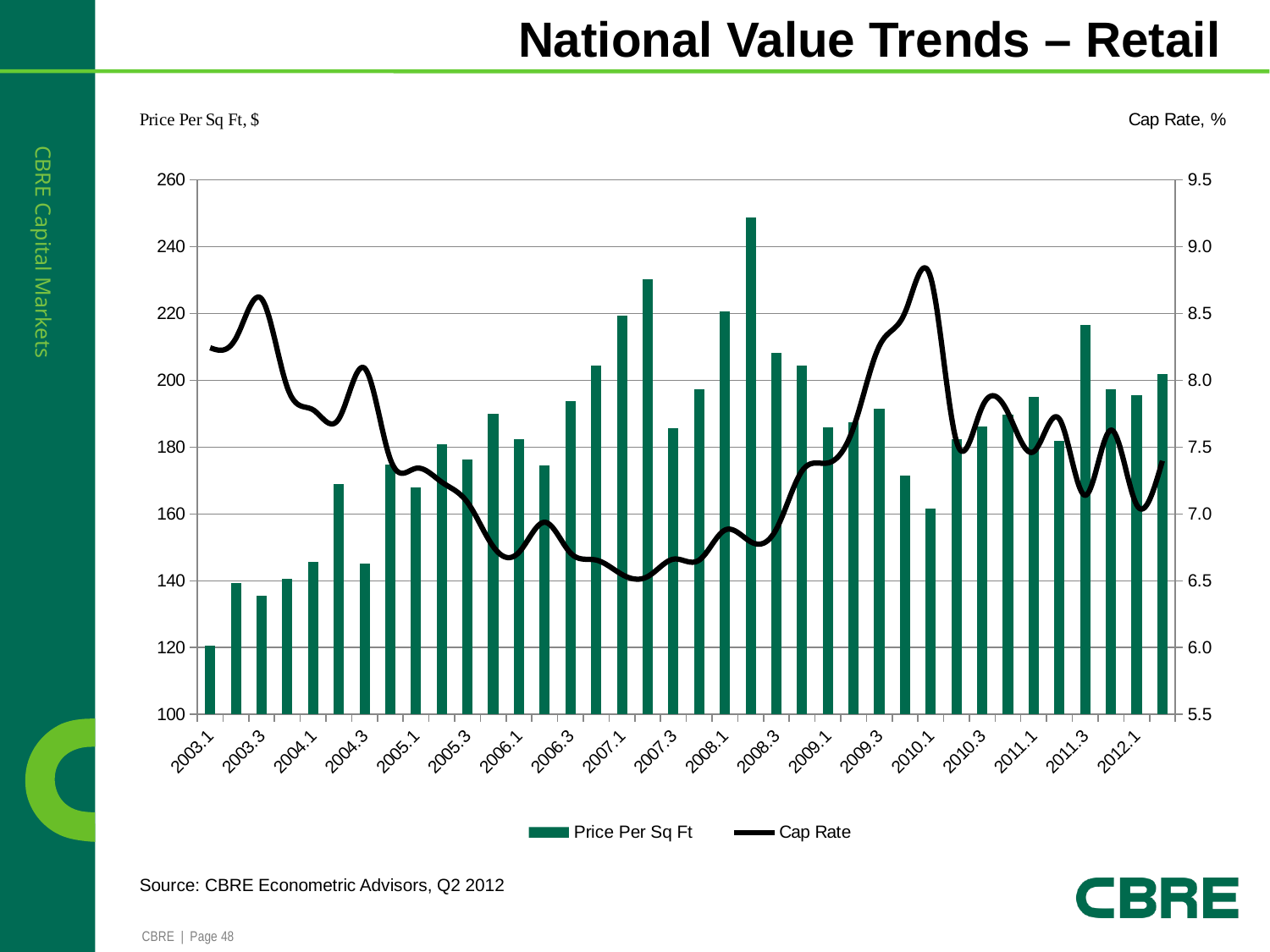
How many series does the legend list? 2 Which has the higher Price Per Sq Ft, 2005.1 or 2007.1? 2007.1 Is the Price Per Sq Ft for 2011.3 greater or less than 200? greater Is the Price Per Sq Ft for 2003.1 greater or less than 140? less Is the Cap Rate for 2007.1 greater or less than 7.0? less What kind of chart is shown on the slide? A combination bar and line chart Which series is plotted as bars and which as a line? Price Per Sq Ft is bars; Cap Rate is a line Does the Cap Rate line generally rise or fall from 2003.3 to 2007.1? fall Which labeled quarter has the lowest Price Per Sq Ft bar? 2003.1 What is the label of the right-hand vertical axis? Cap Rate, %